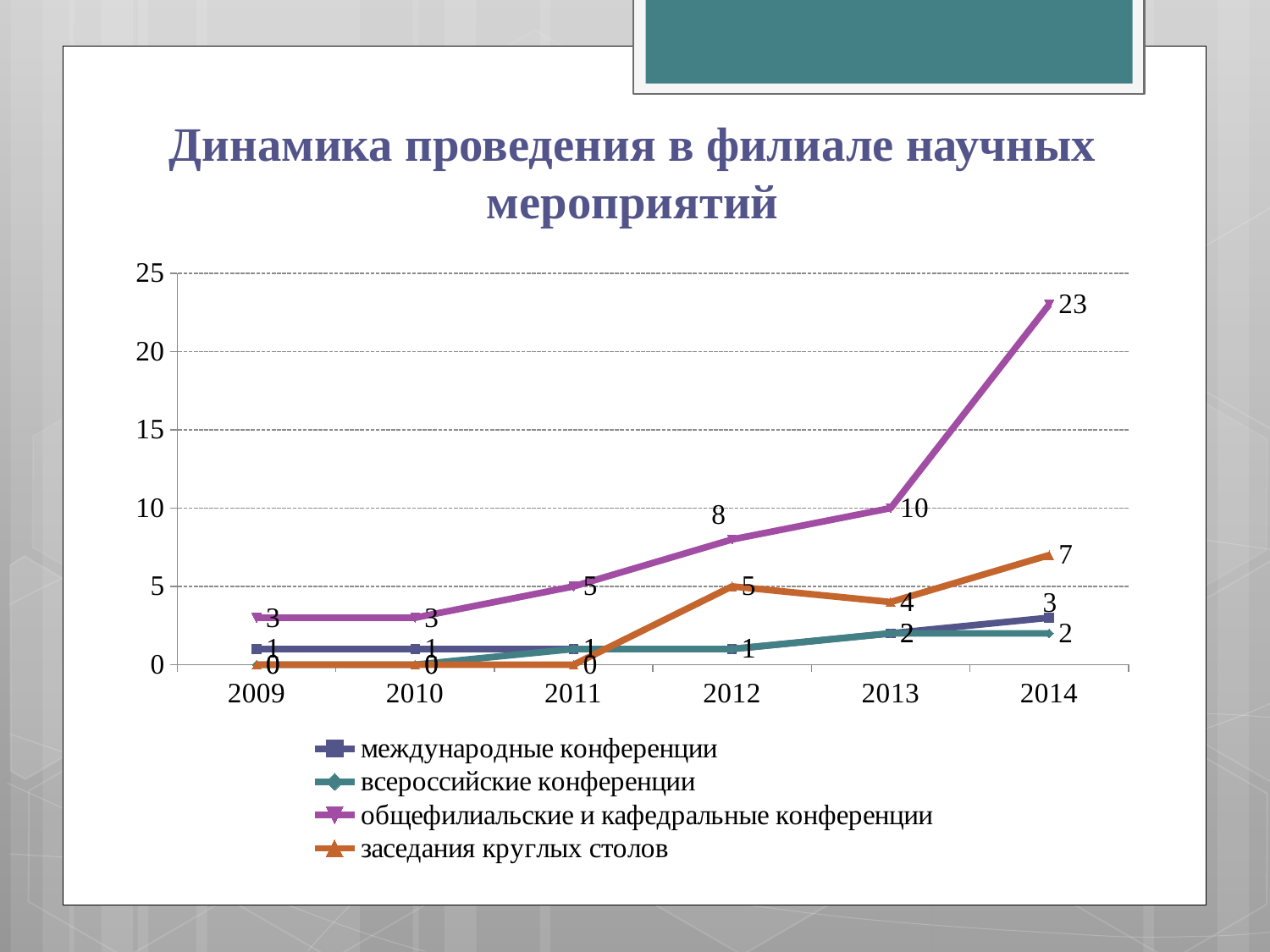
How many series does the legend list? 4 What type of chart is shown on the slide? line chart In which year is the value for общефилиальские и кафедральные конференции highest? 2014 What is the value for общефилиальские и кафедральные конференции in 2014? 23 How many years are shown on the x axis? 6 Which is larger in 2014: международные конференции or всероссийские конференции? международные конференции What is the value for заседания круглых столов in 2014? 7 Is the value for общефилиальские и кафедральные конференции in 2014 greater or less than 20? greater What is the difference between the values for общефилиальские и кафедральные конференции in 2014 and 2013? 13 Does the value for общефилиальские и кафедральные конференции rise or fall from 2009 to 2014? rise What is the value for заседания круглых столов in 2013? 4 What is the value for общефилиальские и кафедральные конференции in 2012? 8